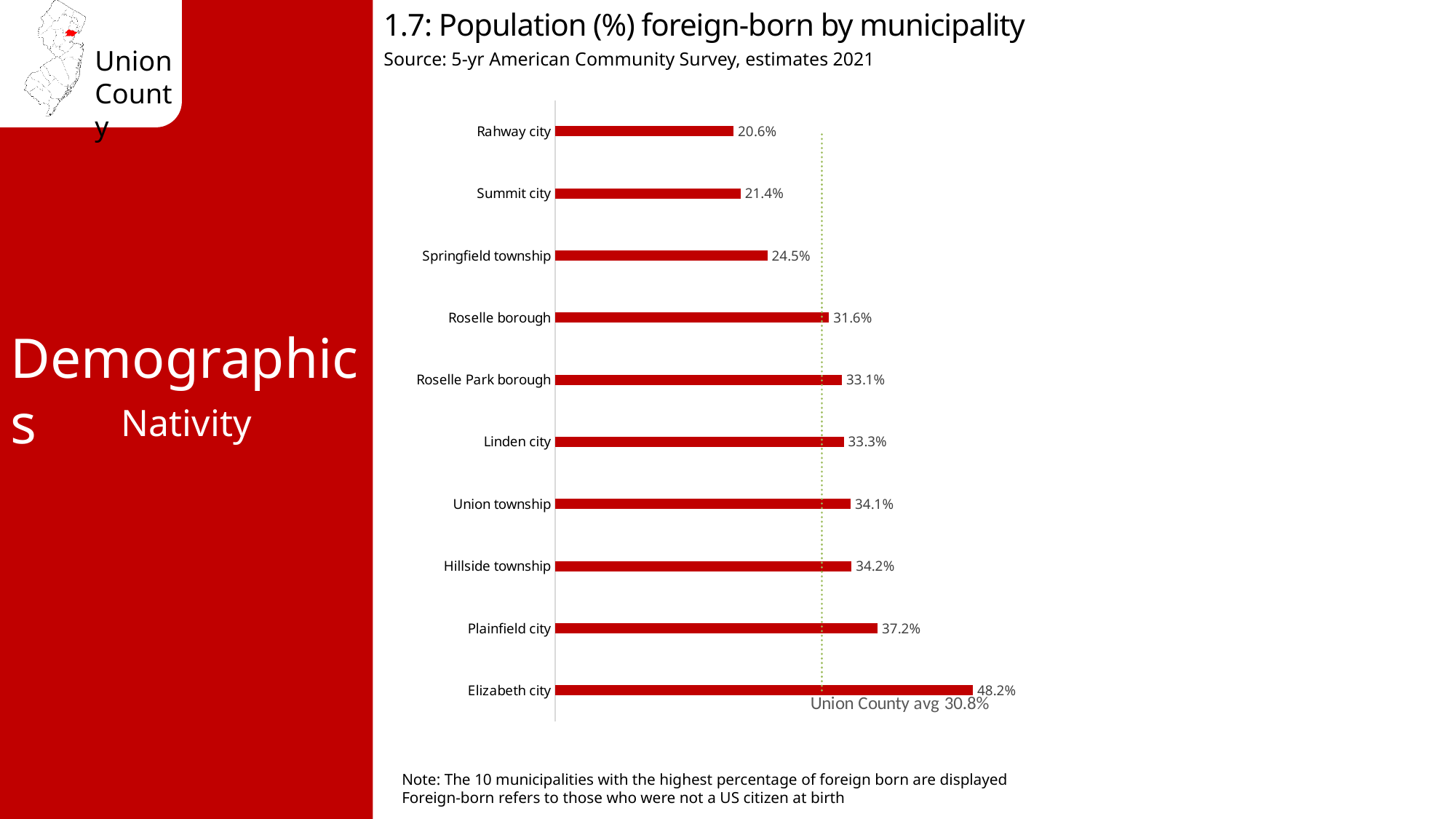
Which municipality has the highest percentage of foreign-born population? Elizabeth city What is the source of the data shown in the chart? 5-yr American Community Survey, estimates 2021 What is the Union County average foreign-born percentage marked by the dotted line? 30.8% How many municipalities are shown in the chart? 10 What is the foreign-born population percentage for Elizabeth city? 48.2% What is the difference in foreign-born percentage between Elizabeth city and Plainfield city? 11.0% What kind of chart is used to show the foreign-born population by municipality? Bar chart Which municipality has the lowest percentage of foreign-born population? Rahway city Which has a higher foreign-born percentage, Roselle borough or Springfield township? Roselle borough What is the difference in foreign-born percentage between Summit city and Rahway city? 0.8% What is the foreign-born population percentage for Springfield township? 24.5% What is the foreign-born population percentage for Linden city? 33.3%